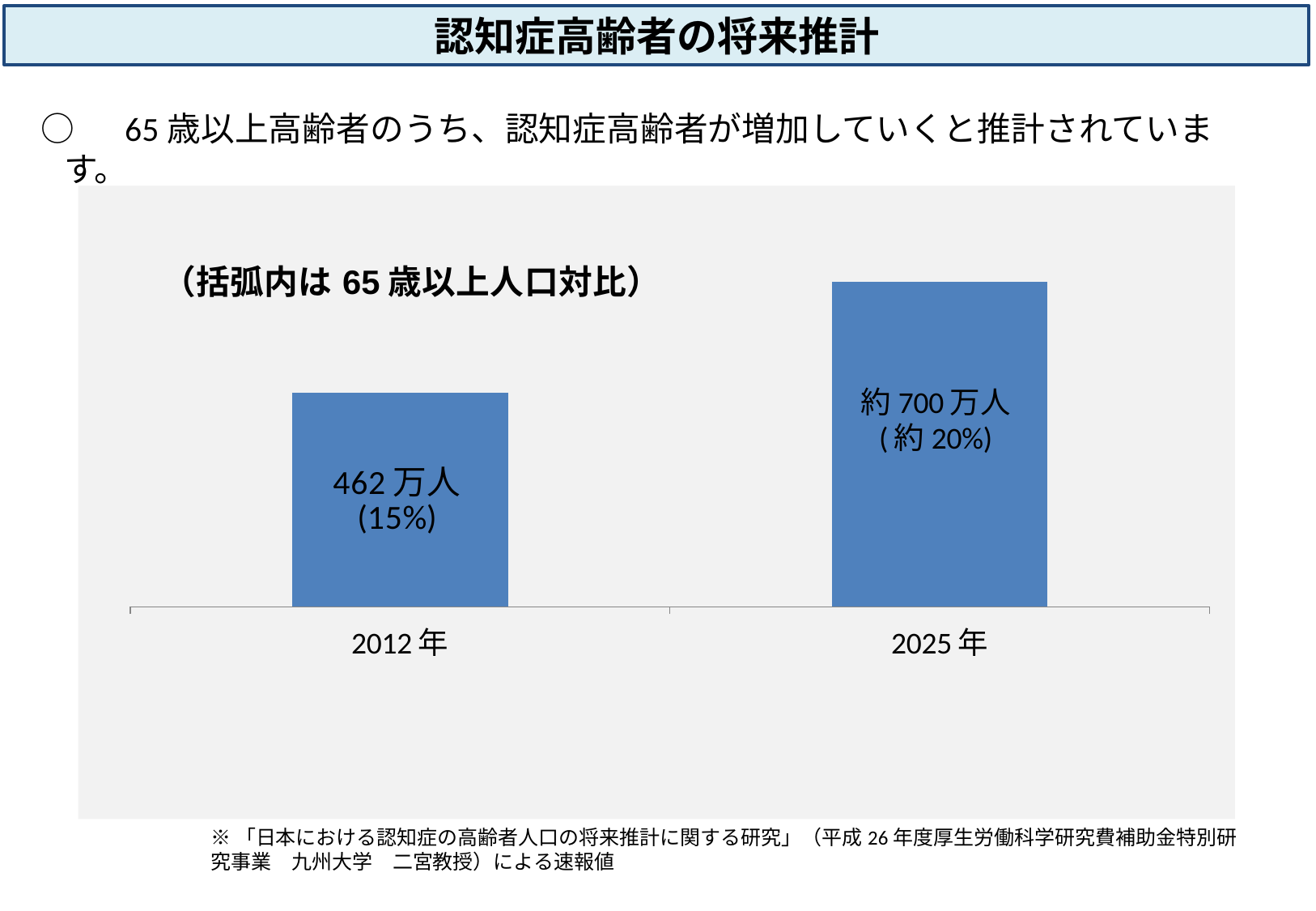
What percentage is shown in parentheses for 2025年? 約20% Which year has the lower bar? 2012年 According to the note in the chart, what do the figures in parentheses represent? 65歳以上人口対比 What kind of chart is shown on the slide? bar chart Do the values rise or fall from 2012年 to 2025年? rise What percentage of the 65歳以上 population is shown in parentheses for 2012年? 15% How many bars are plotted in the chart? 2 What is the value shown for 2012年? 462万人 What is the title of the slide containing the chart? 認知症高齢者の将来推計 Which year has the higher bar? 2025年 Is the value for 2025年 larger or smaller than the value for 2012年? larger What is the value shown for 2025年? 約700万人